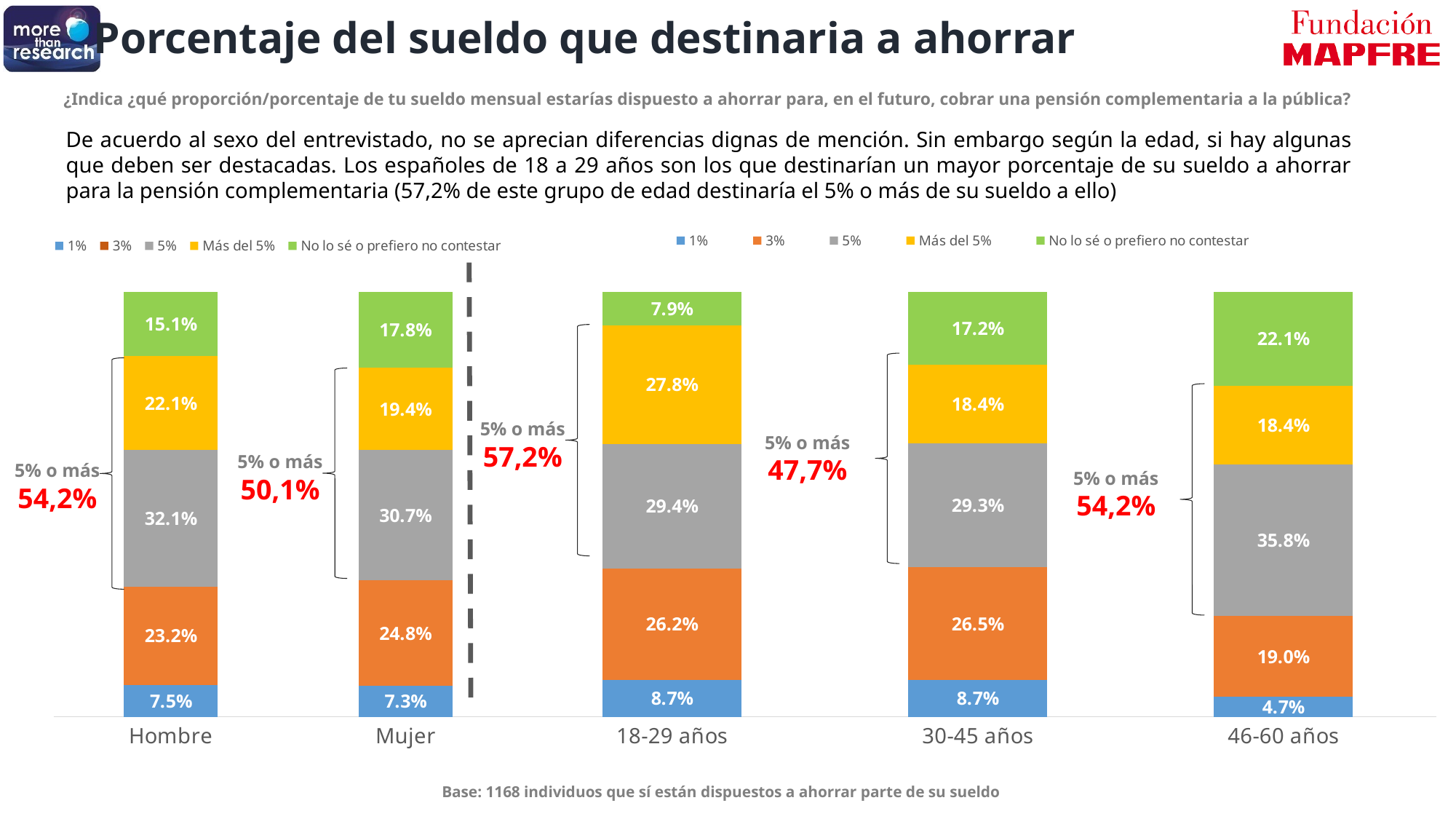
In the right chart (by age), what is the value of the 1% segment for 46-60 años? 4.7% In the left chart (by sex), what is the difference between the 3% segment for Mujer and for Hombre? 1.6% In the right chart (by age), which is larger: the 5% segment for 46-60 años or for 30-45 años? 46-60 años In the right chart (by age), what '5% o más' percentage is annotated for the 30-45 años group? 47,7% How many series does the legend of the left chart list? 5 In the right chart (by age), which age group has the lowest value for the 3% segment? 46-60 años In the right chart (by age), what percentage of the 18-29 años group would save 'Más del 5%'? 27.8% In the left chart (by sex), what percentage of Hombre would save 5% of their salary? 32.1% What kind of chart is used on this slide? Stacked bar chart In the left chart (by sex), what is the value of 'No lo sé o prefiero no contestar' for Mujer? 17.8% In the right chart (by age), which age group has the highest value for 'No lo sé o prefiero no contestar'? 46-60 años How many age groups are shown in the right chart? 3